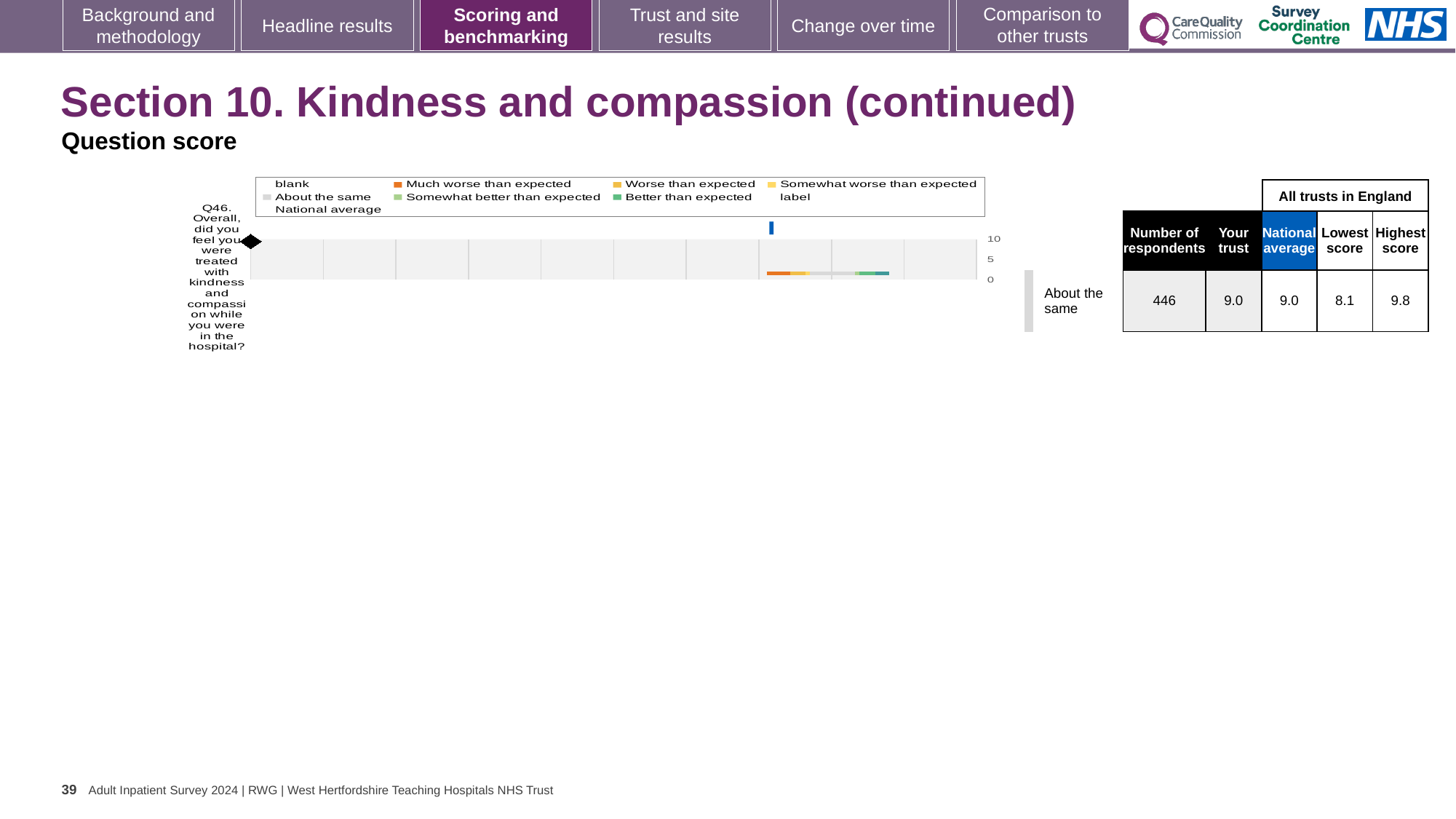
Which benchmark category is the trust's result for Q46 placed in? About the same What is the highest score among all trusts in England for Q46? 9.8 How many questions (categories) are plotted on the chart? 1 Is the trust's score for Q46 higher than, lower than, or the same as the national average? the same Which question number is plotted on the chart? Q46 What is the national average score for Q46? 9.0 What is the lowest score among all trusts in England for Q46? 8.1 What is the 'Your trust' score for Q46? 9.0 What is the highest value shown on the chart's axis? 10 What kind of chart is shown on the slide? bar chart What is the difference between the highest score and the lowest score for Q46? 1.7 What is the number of respondents for Q46? 446